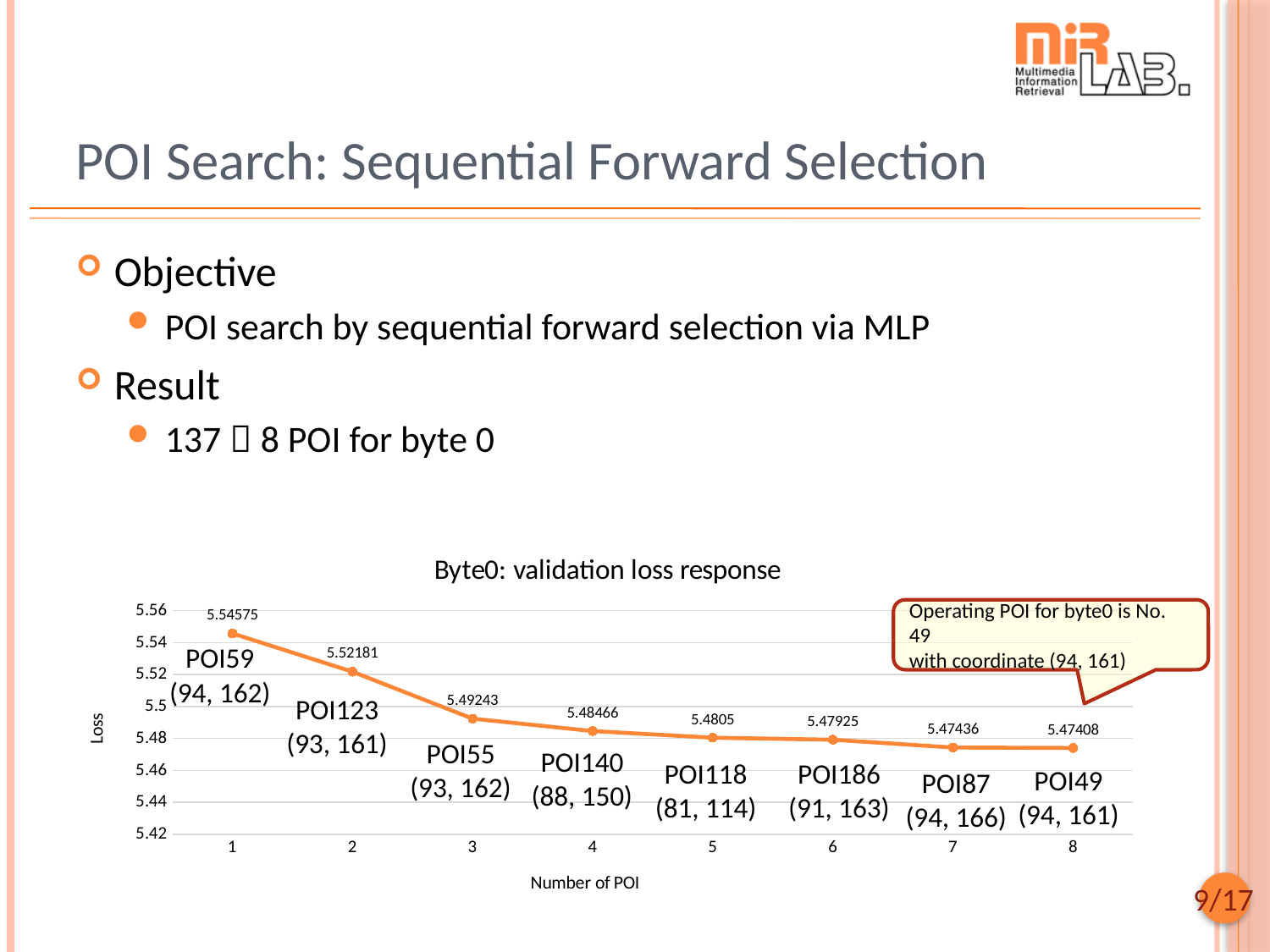
What is the difference in validation loss between 1 POI and 2 POI? 0.02394 What kind of chart is shown on the slide? line chart At which number of POI is the validation loss lowest? 8 What is the validation loss when the number of POI is 4? 5.48466 How many data points are plotted on the chart? 8 Is the validation loss at 2 POI greater or less than 5.5? greater What is the title of the chart? Byte0: validation loss response What is the validation loss when the number of POI is 8? 5.47408 Does the validation loss rise or fall as the number of POI increases? fall What is the validation loss when the number of POI is 1? 5.54575 At which number of POI is the validation loss highest? 1 Which has a higher validation loss, 3 POI or 5 POI? 3 POI